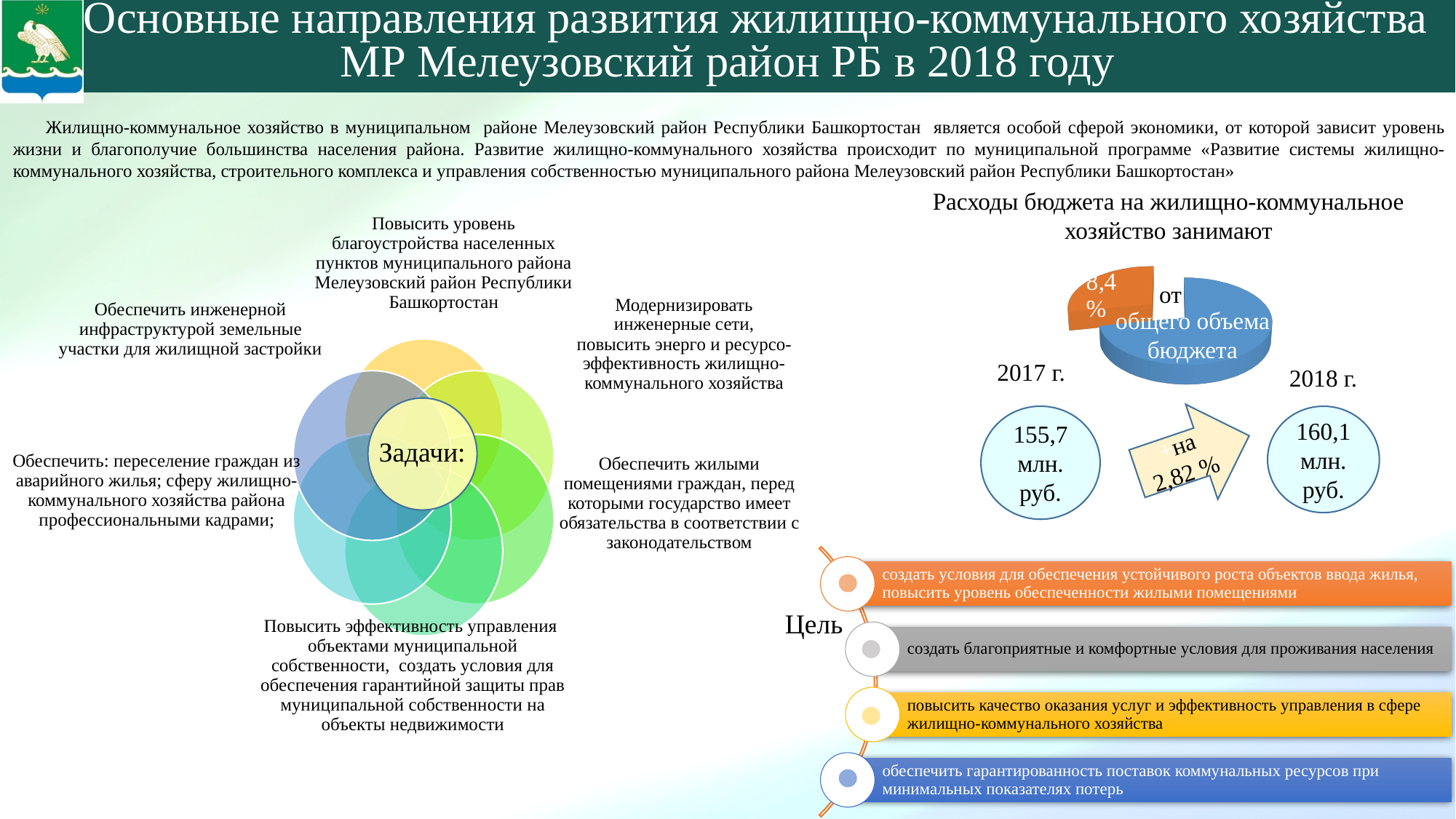
What does the text inside the large blue slice of the pie chart say? от общего объема бюджета What kind of chart is shown under the heading "Расходы бюджета на жилищно-коммунальное хозяйство занимают"? pie chart In the pie chart, what share of the total budget is shown for housing and communal services (the orange slice)? 8,4% In the pie chart, which slice is larger: the orange slice or the blue slice? the blue slice How many slices does the pie chart have? 2 What colour is the slice of the pie chart labelled 8,4%? orange Is the share shown for the orange slice of the pie chart greater or less than 10%? less